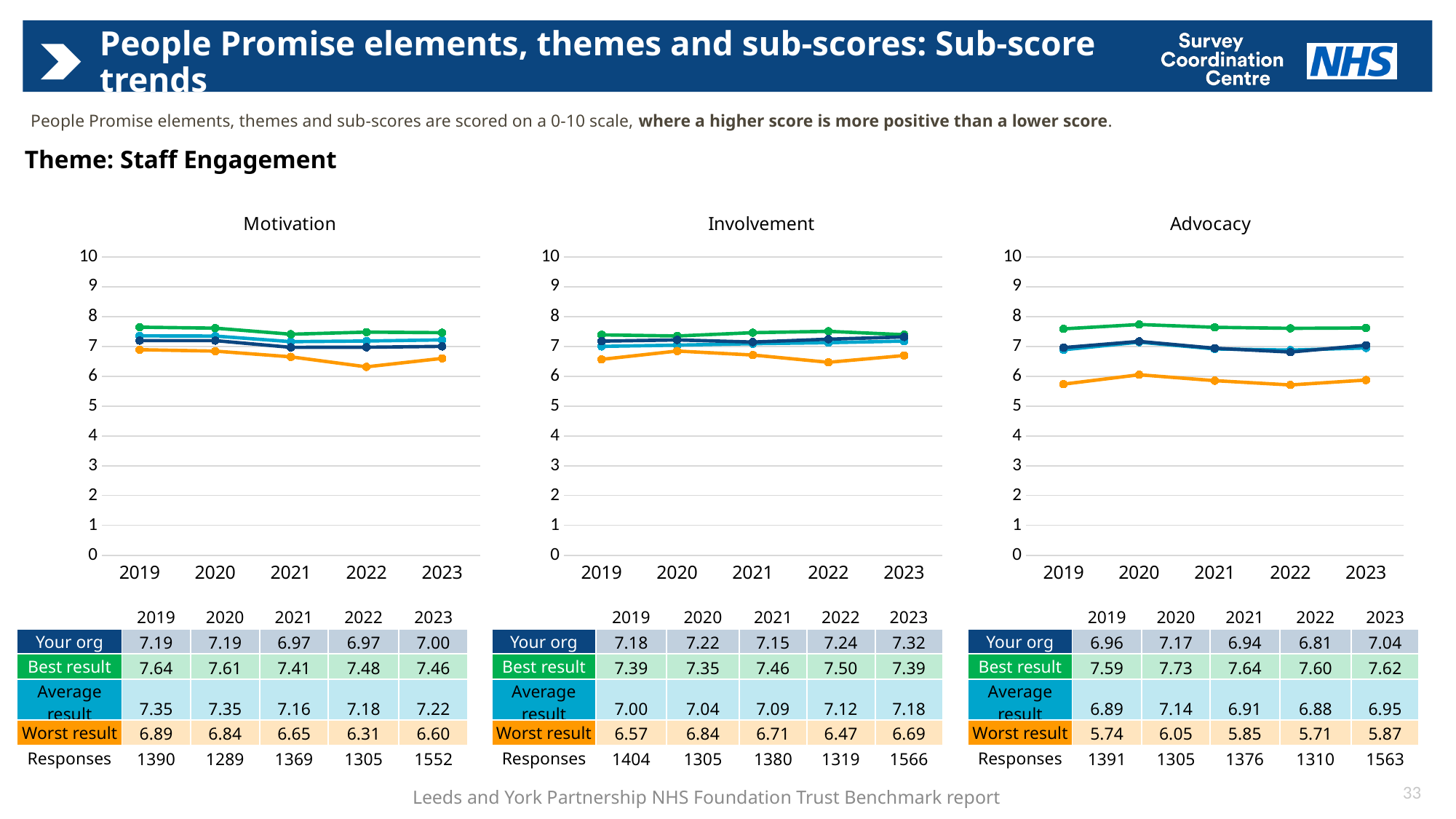
In the Involvement chart, what was the Best result score in 2022? 7.50 In the Motivation chart, what is the difference between the Best result and Your org scores in 2019? 0.45 In the Advocacy chart, in which year was the Your org score lowest? 2022 How many years are plotted on the x axis of the Involvement chart? 5 In the Advocacy chart, is the Worst result value for 2019 greater or less than 6? less In the Involvement chart, does the Average result score rise or fall from 2019 to 2023? rise In the Motivation chart, what was the Your org score in 2023? 7.00 In the Advocacy chart, what was the Worst result score in 2020? 6.05 In the Advocacy chart, which is larger in 2023: the Your org score or the Average result score? Your org What type of chart is the Motivation chart? line chart In the Involvement chart, in which year was the Your org score highest? 2023 In the Motivation chart, in which year was the Worst result score lowest? 2022